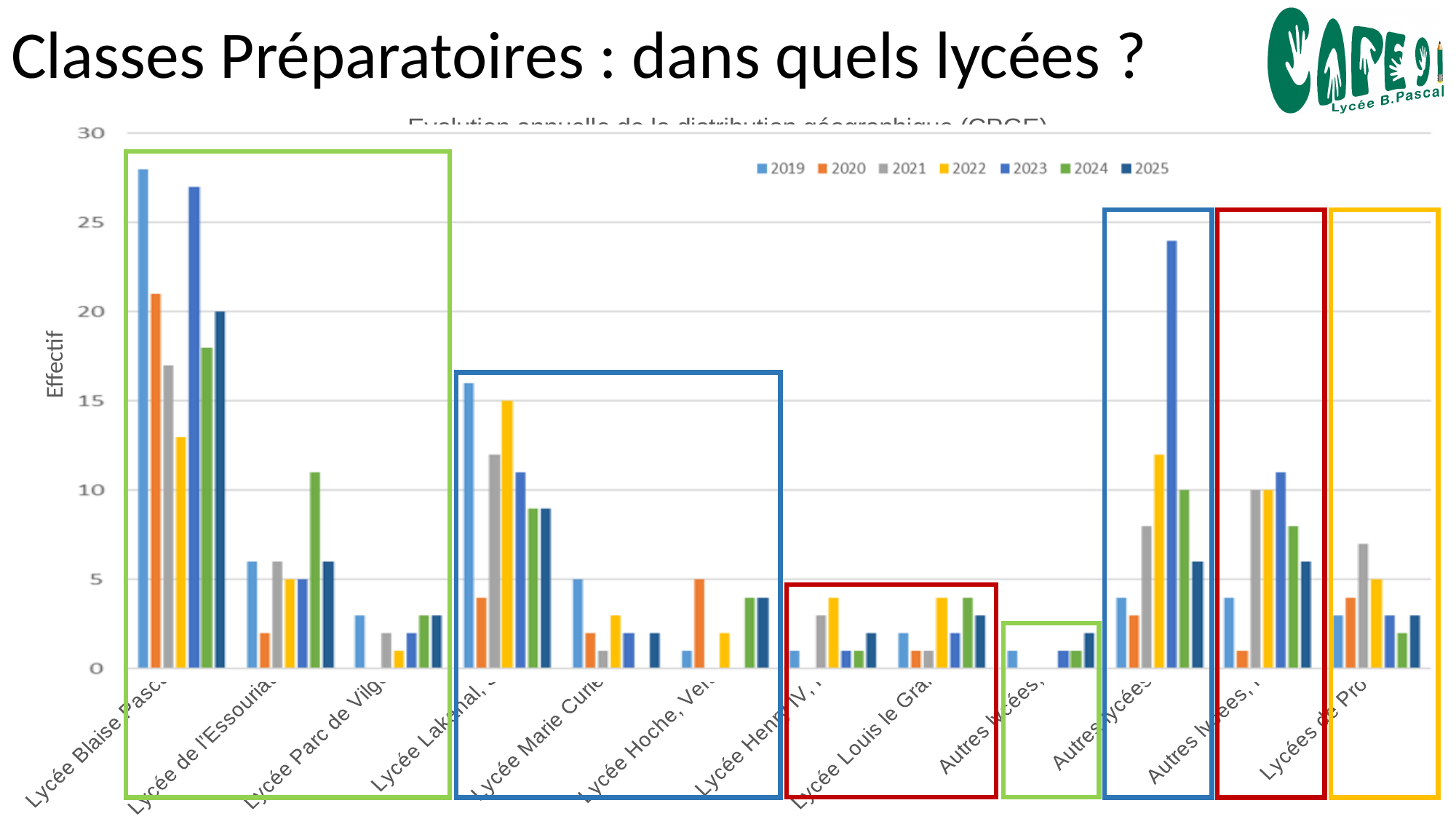
Which year does the yellow series in the legend represent? 2022 Is the 2021 value for Lycée Lakanal greater or less than 10? greater How many lycée categories are shown along the x axis of the chart? 12 For Lycée Blaise Pascal, which year has the lowest value? 2022 Is the 2024 value for Lycée de l'Essouriau greater or less than 10? greater What is the label of the vertical axis of the chart? Effectif Is the 2022 value for Lycée Louis le Grand greater or less than 5? less How many series does the chart legend list? 7 For Lycée de l'Essouriau, which year has the highest value? 2024 For Lycée Blaise Pascal, which is larger: the 2020 value or the 2021 value? 2020 What kind of chart is shown on the slide? bar chart